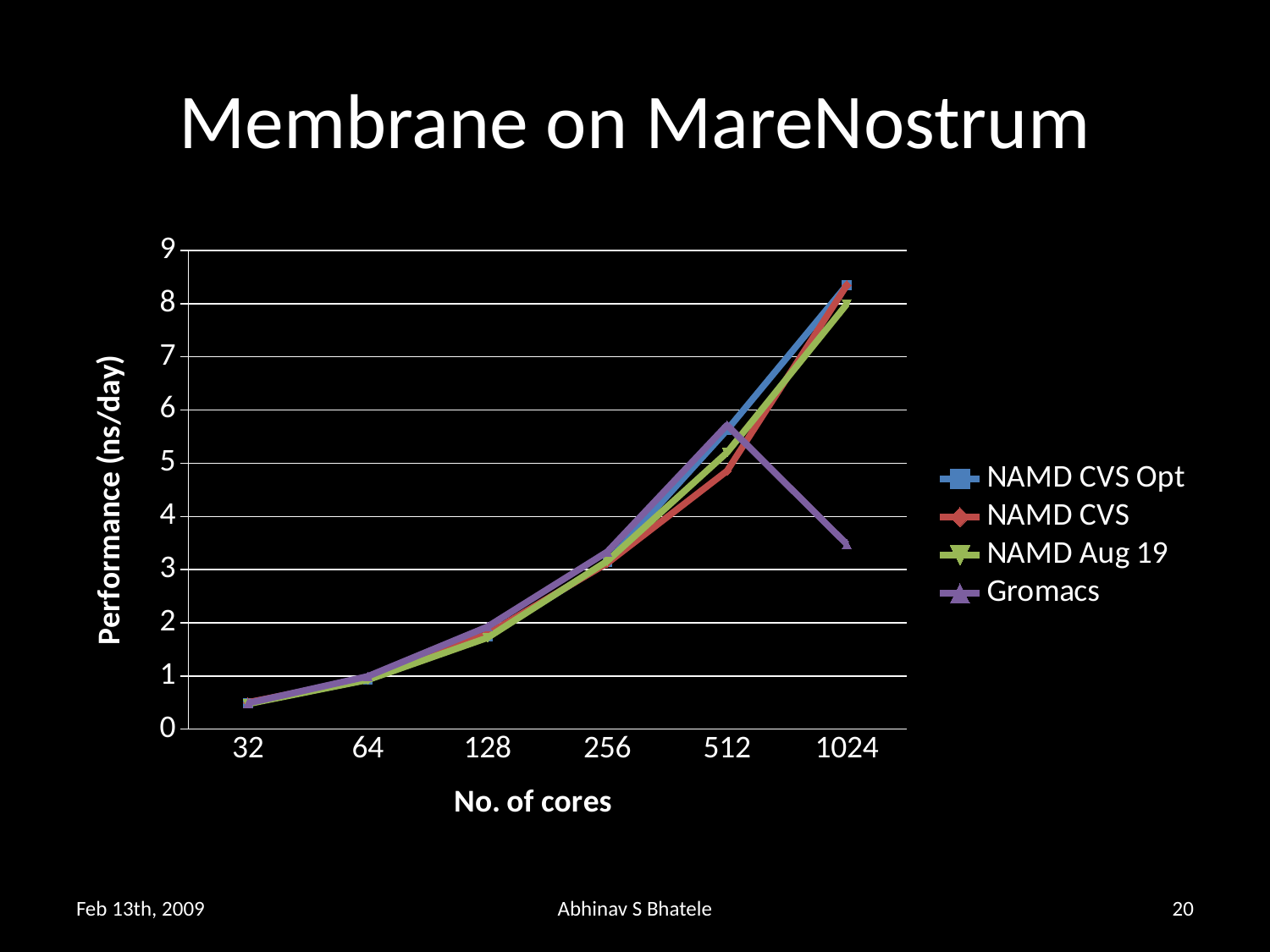
What is the title of the chart? Membrane on MareNostrum Is the value for Gromacs at 512 cores greater or less than 5? greater What is the label of the y axis? Performance (ns/day) Is the value for NAMD CVS at 512 cores greater or less than 5? less At 512 cores, which is larger: Gromacs or NAMD CVS? Gromacs Does the NAMD CVS Opt series rise or fall as the number of cores increases? rise How many series does the legend list? 4 At 1024 cores, which series has the lowest performance? Gromacs Is the value for NAMD CVS Opt at 1024 cores greater or less than 8? greater How many core counts are plotted along the x axis? 6 What kind of chart is shown on the slide? line chart